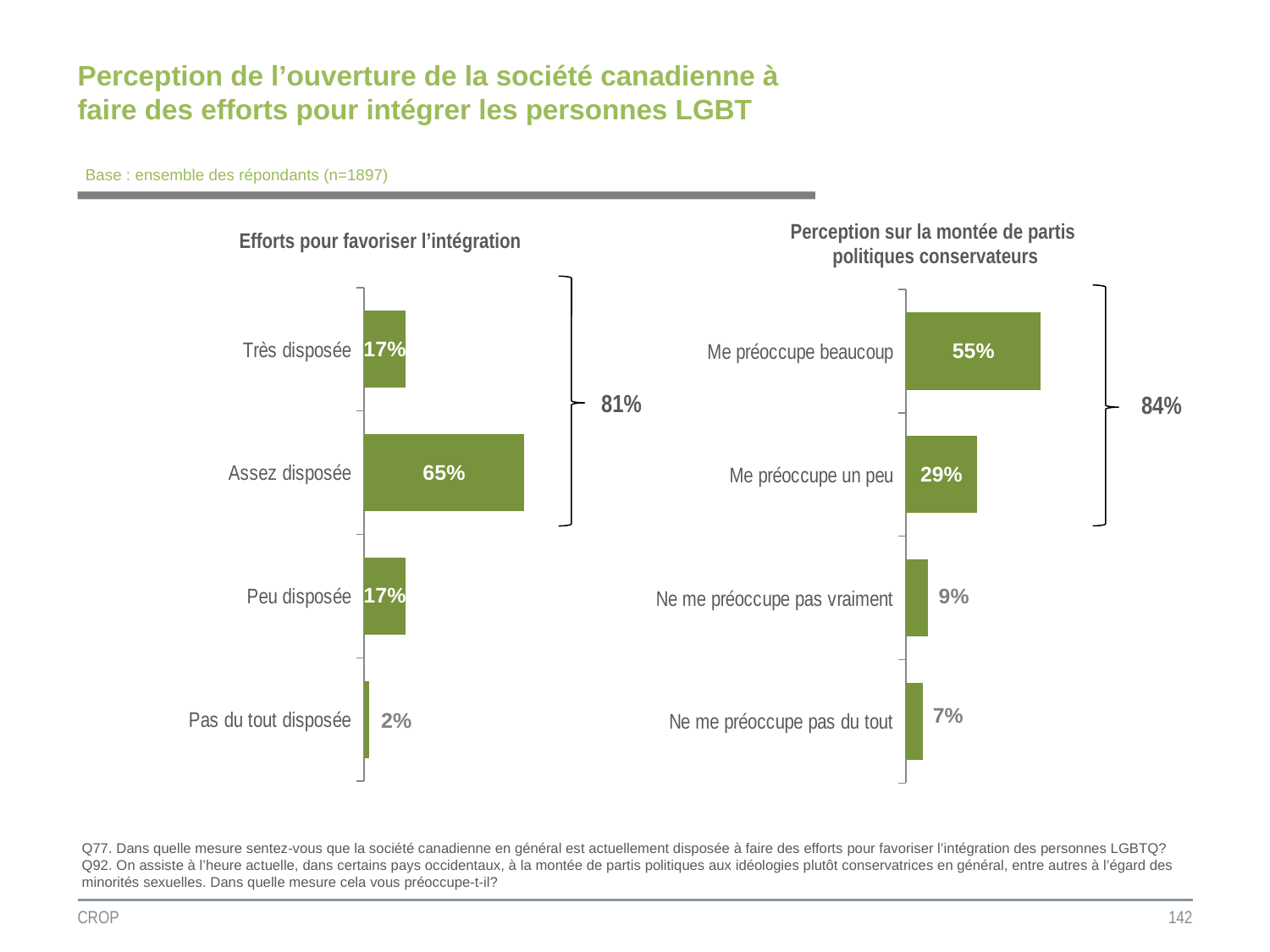
In the 'Perception sur la montée de partis politiques conservateurs' chart, what is the difference between 'Me préoccupe beaucoup' and 'Me préoccupe un peu'? 26% In the 'Efforts pour favoriser l'intégration' chart, what combined value does the bracket next to 'Très disposée' and 'Assez disposée' show? 81% In the 'Efforts pour favoriser l'intégration' chart, what is the value for 'Assez disposée'? 65% In the 'Perception sur la montée de partis politiques conservateurs' chart, what is the value for 'Ne me préoccupe pas du tout'? 7% In the 'Perception sur la montée de partis politiques conservateurs' chart, what is the value for 'Me préoccupe beaucoup'? 55% In the 'Efforts pour favoriser l'intégration' chart, which category has the highest value? Assez disposée What kind of chart is the 'Perception sur la montée de partis politiques conservateurs' chart? Bar chart In the 'Efforts pour favoriser l'intégration' chart, what is the difference between 'Assez disposée' and 'Très disposée'? 48% How many categories does the 'Efforts pour favoriser l'intégration' chart show? 4 In the 'Efforts pour favoriser l'intégration' chart, what is the value for 'Pas du tout disposée'? 2% In the 'Perception sur la montée de partis politiques conservateurs' chart, which is larger: 'Ne me préoccupe pas vraiment' or 'Ne me préoccupe pas du tout'? Ne me préoccupe pas vraiment In the 'Perception sur la montée de partis politiques conservateurs' chart, which category has the lowest value? Ne me préoccupe pas du tout